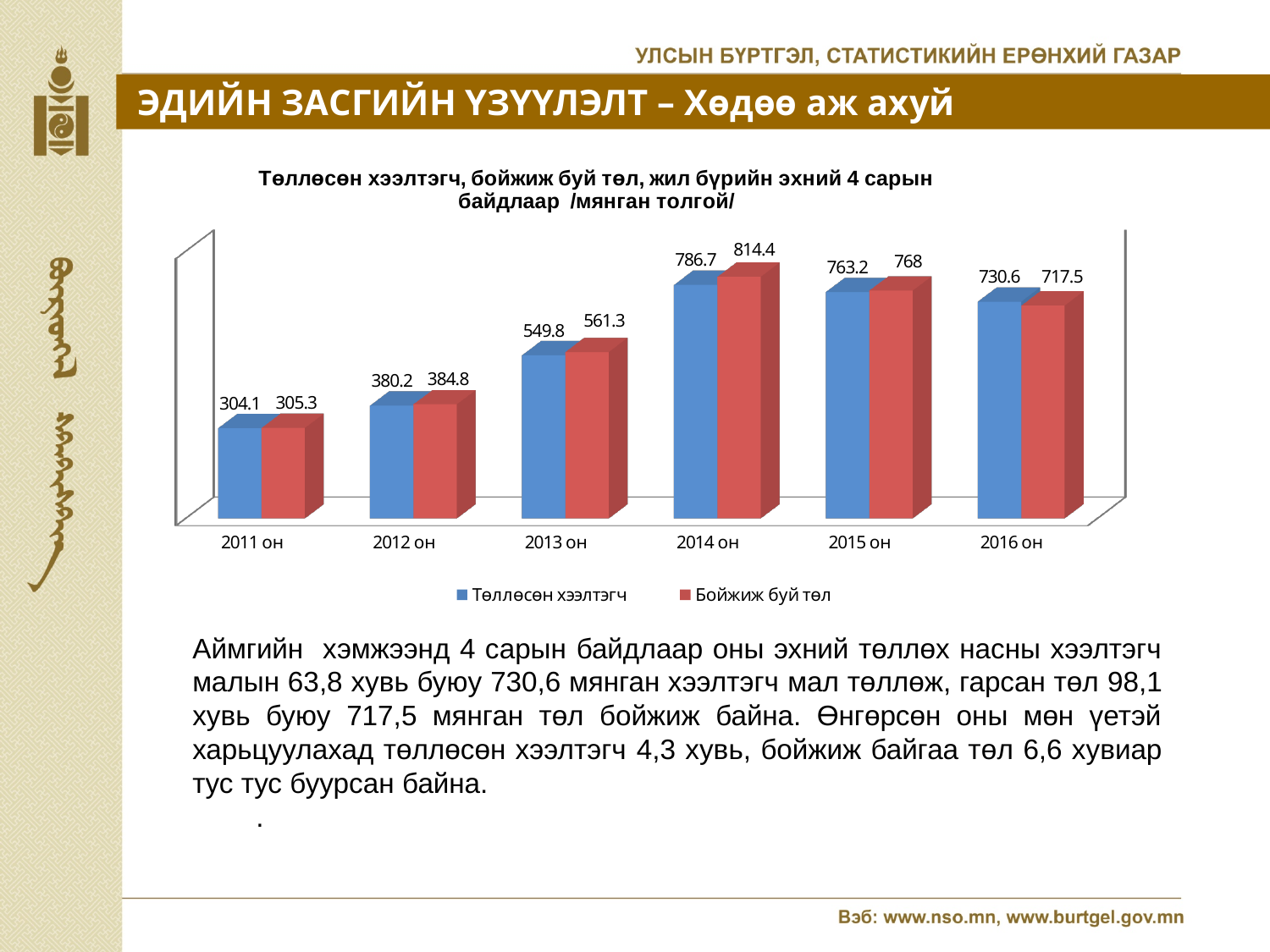
In which year is the Бойжиж буй төл value highest? 2014 он In which year is the Төллөсөн хээлтэгч value lowest? 2011 он What kind of chart is shown on the slide? Bar chart How many years are shown on the x axis of the chart? 6 What is the value for Төллөсөн хээлтэгч in 2014 он? 786.7 What is the difference between the Бойжиж буй төл and Төллөсөн хээлтэгч values in 2014 он? 27.7 What is the difference between the Төллөсөн хээлтэгч values for 2013 он and 2012 он? 169.6 Which is larger in 2016 он: Төллөсөн хээлтэгч or Бойжиж буй төл? Төллөсөн хээлтэгч Which colour represents the Бойжиж буй төл series? Red What is the value for Бойжиж буй төл in 2016 он? 717.5 What is the value for Бойжиж буй төл in 2012 он? 384.8 How many series does the legend list? 2